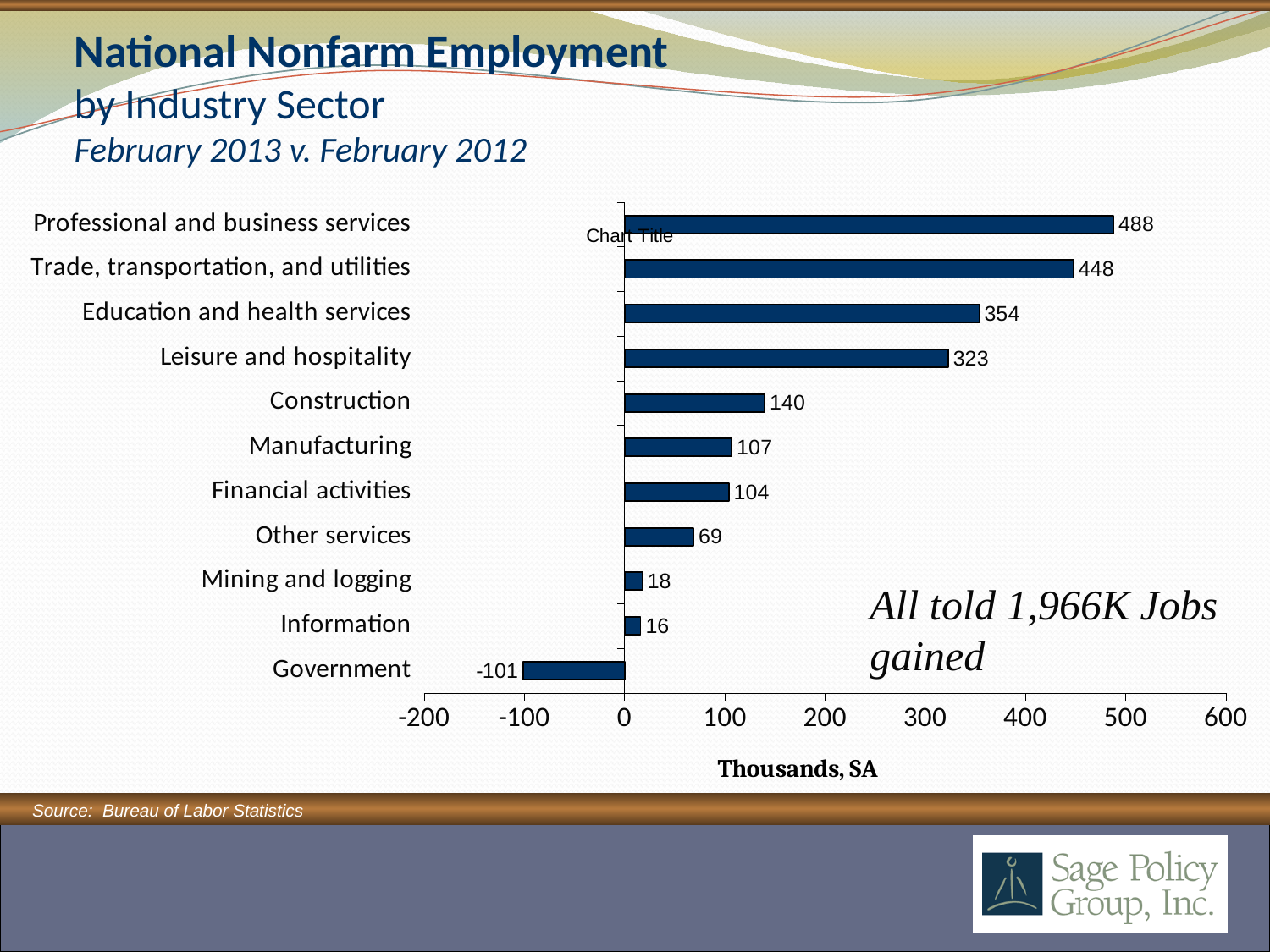
How many industry sectors are shown in the chart? 11 Which is larger, the value for Construction or the value for Manufacturing? Construction What is the value for Professional and business services? 488 What kind of chart is shown on the slide? Bar chart What is the difference between the values for Professional and business services and Trade, transportation, and utilities? 40 Which industry sector has the highest value? Professional and business services What is the value for Government? -101 Is the value for Education and health services greater or less than 300? greater What is the value for Leisure and hospitality? 323 What is the difference between the values for Mining and logging and Information? 2 Which industry sector has the lowest value? Government What is the label on the horizontal axis of the chart? Thousands, SA